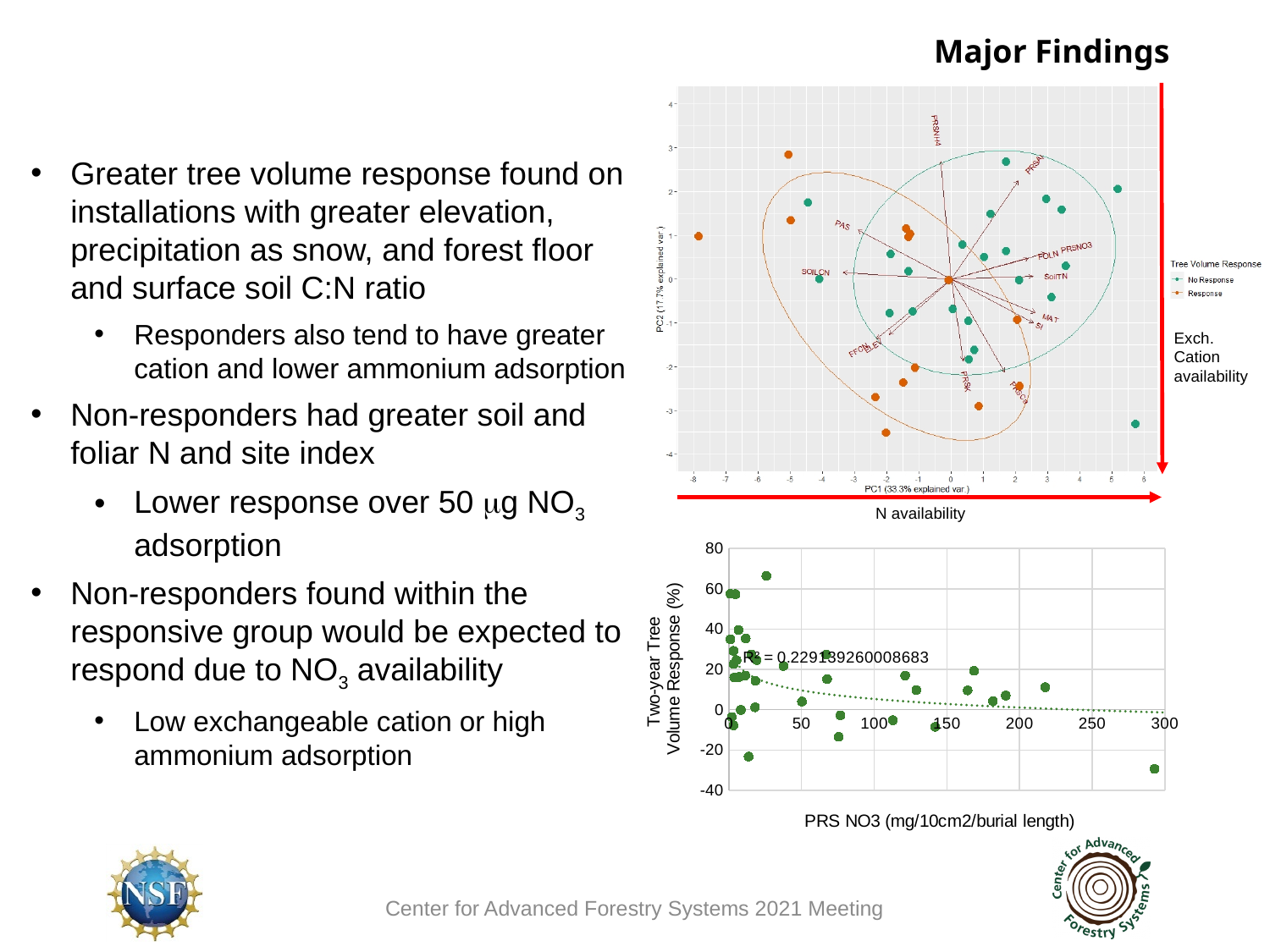
How many series does the legend of the top PCA chart list under Tree Volume Response? 2 In the bottom scatter chart, what R-squared value is printed on the chart? R² = 0.229139260008683 In the bottom scatter chart, does the dotted trendline rise or fall as PRS NO3 increases along the x axis? fall What kind of chart is the bottom chart with the x axis labelled PRS NO3 (mg/10cm2/burial length)? scatter chart In the bottom scatter chart, what is the highest tick value shown on the x axis? 300 In the top PCA chart, what percentage of explained variance is given for PC1 on the x axis? 33.3% In the bottom scatter chart, is the lowest plotted point greater or less than -20 on the y axis? less In the top PCA chart, what are the two legend entries under Tree Volume Response? No Response, Response In the bottom scatter chart, is the value of the point plotted near 300 on the x axis greater or less than 0? less In the bottom scatter chart, what is the label of the y axis? Two-year Tree Volume Response (%) In the bottom scatter chart, is the highest plotted Two-year Tree Volume Response value greater or less than 60? greater In the top PCA chart, what percentage of explained variance is given for PC2 on the y axis? 17.7%